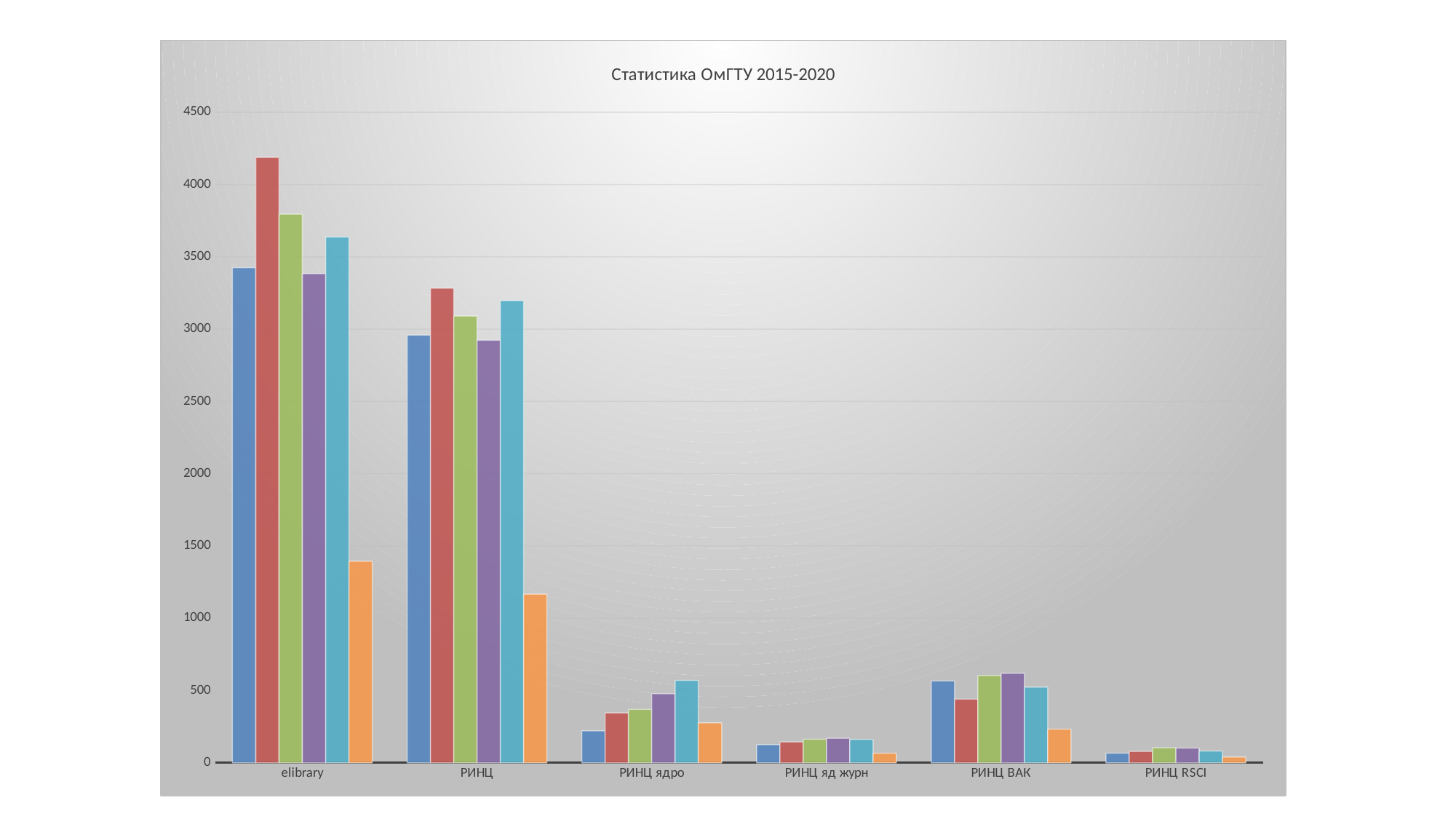
Is the tallest bar for elibrary greater or less than 4000? greater Is the tallest bar for РИНЦ ВАК greater or less than 1000? less Does the chart display a legend? No What kind of chart is shown on the slide? bar chart Which category contains the tallest bar in the chart? elibrary How many categories are shown on the x axis of the chart? 6 Is the shortest bar for elibrary greater or less than 1000? greater What is the title of the chart? Статистика ОмГТУ 2015-2020 Which category has the taller maximum bar, elibrary or РИНЦ? elibrary Which category has the lowest bars in the chart? РИНЦ RSCI How many bars are plotted for each category in the chart? 6